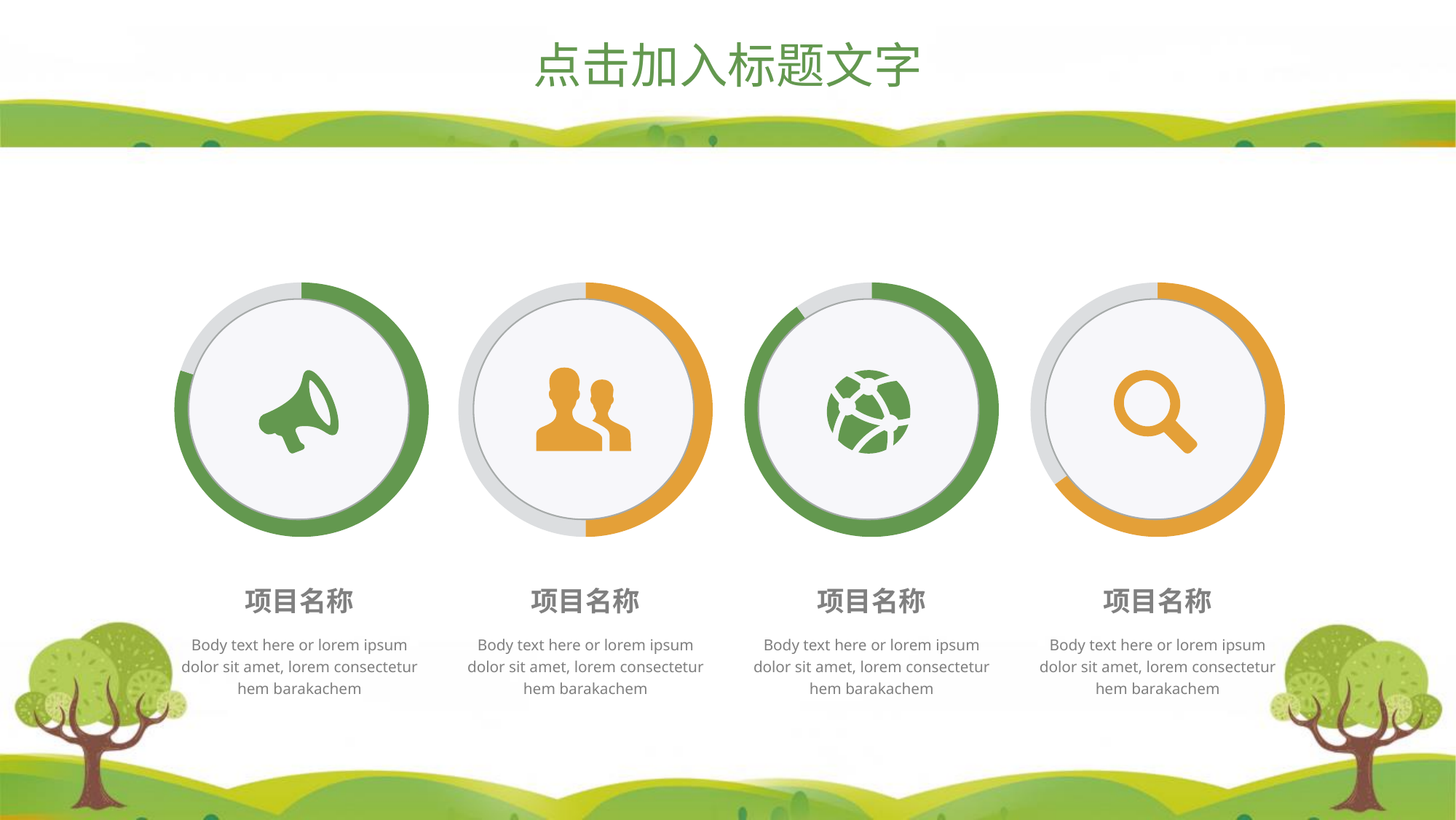
How many ring charts are shown on the slide? 4 What kind of chart is used for each of the four indicators on the slide? Donut (ring) chart Which ring chart has the largest filled portion? The third from the left (green, globe icon) Is the filled portion of the first ring chart (megaphone icon) larger or smaller than that of the second ring chart (people icon)? Larger Is the filled portion of the third ring chart (globe icon) larger or smaller than that of the fourth ring chart (magnifier icon)? Larger Which ring chart has the smallest filled portion? The second from the left (orange, people icon) What label appears under each of the four ring charts? 项目名称 What colour is the filled portion of the second ring chart from the left? Orange